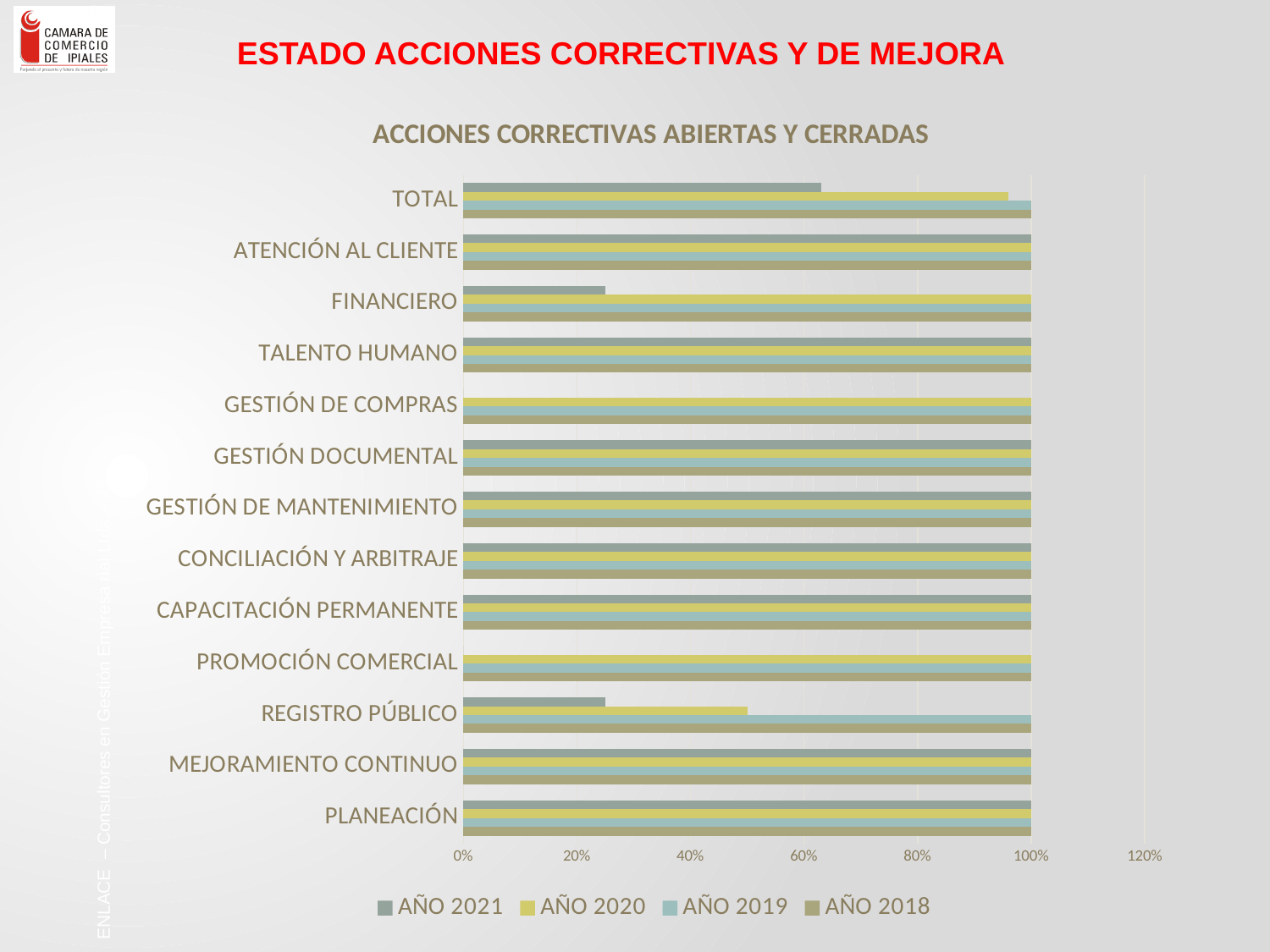
For FINANCIERO, which is larger: the AÑO 2020 value or the AÑO 2021 value? AÑO 2020 Which series is listed first in the legend? AÑO 2021 Is the value for REGISTRO PÚBLICO in the AÑO 2020 series greater or less than 80%? less What kind of chart is shown on the slide? Bar chart What is the value for FINANCIERO in the AÑO 2020 series? 100% In the AÑO 2020 series, which category has the lowest value? REGISTRO PÚBLICO How many series does the legend list? 4 How many categories are shown on the vertical axis of the chart? 13 Is the value for TOTAL in the AÑO 2021 series greater or less than 80%? less What is the value for PLANEACIÓN in the AÑO 2018 series? 100% Is the value for FINANCIERO in the AÑO 2021 series greater or less than 40%? less What is the title of the chart? ACCIONES CORRECTIVAS ABIERTAS Y CERRADAS